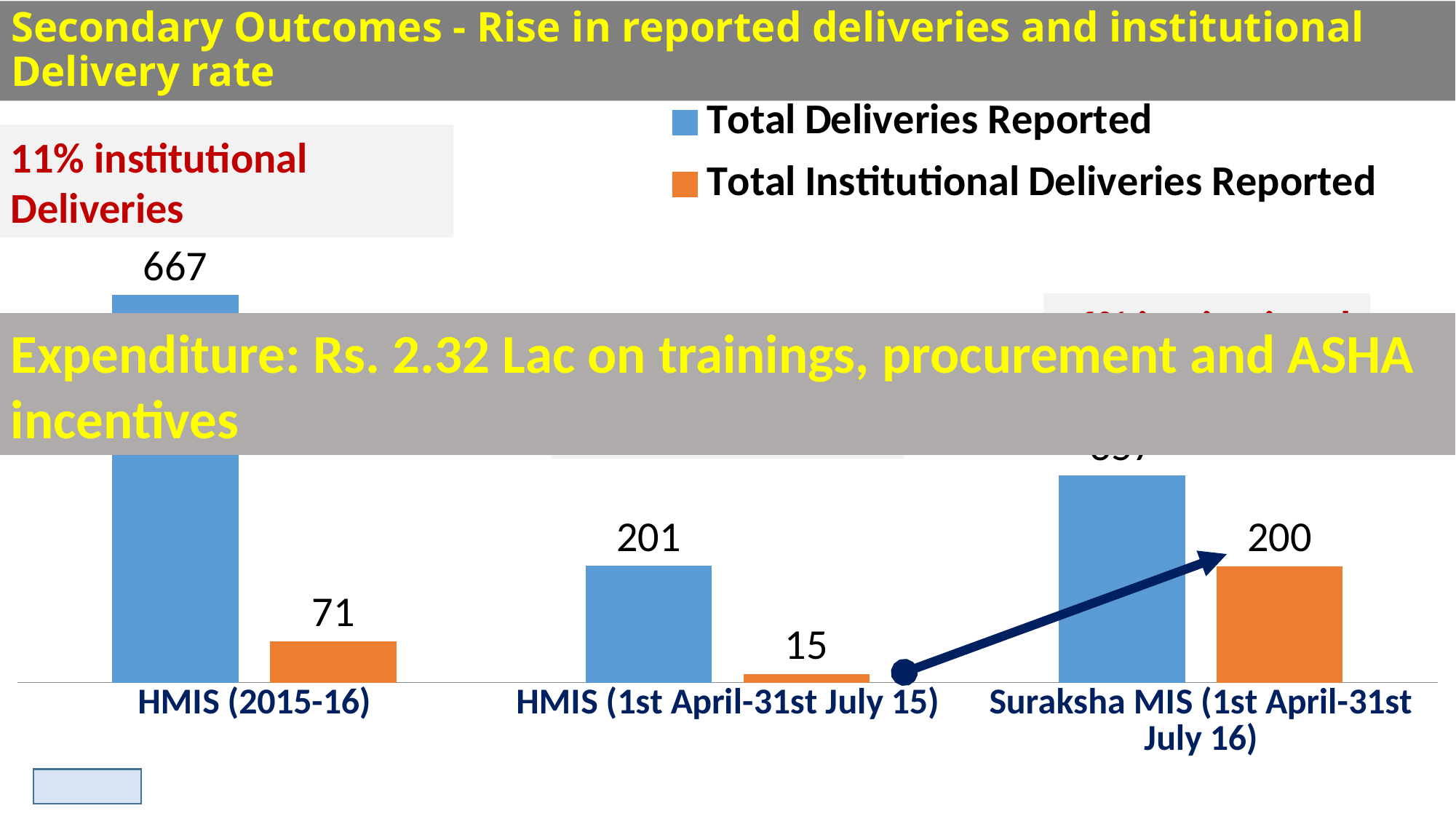
What is the difference between Total Institutional Deliveries Reported for Suraksha MIS (1st April-31st July 16) and HMIS (1st April-31st July 15)? 185 Which category has the highest Total Institutional Deliveries Reported? Suraksha MIS (1st April-31st July 16) What is the value of Total Institutional Deliveries Reported for HMIS (2015-16)? 71 What is the value of Total Institutional Deliveries Reported for Suraksha MIS (1st April-31st July 16)? 200 Which is larger: Total Deliveries Reported for HMIS (2015-16) or for HMIS (1st April-31st July 15)? HMIS (2015-16) What is the value of Total Deliveries Reported for HMIS (2015-16)? 667 How many series does the chart legend list? 2 How many categories are shown on the x axis of the chart? 3 What is the value of Total Deliveries Reported for HMIS (1st April-31st July 15)? 201 Which category has the highest Total Deliveries Reported? HMIS (2015-16) What is the value of Total Institutional Deliveries Reported for HMIS (1st April-31st July 15)? 15 Which category has the lowest Total Institutional Deliveries Reported? HMIS (1st April-31st July 15)